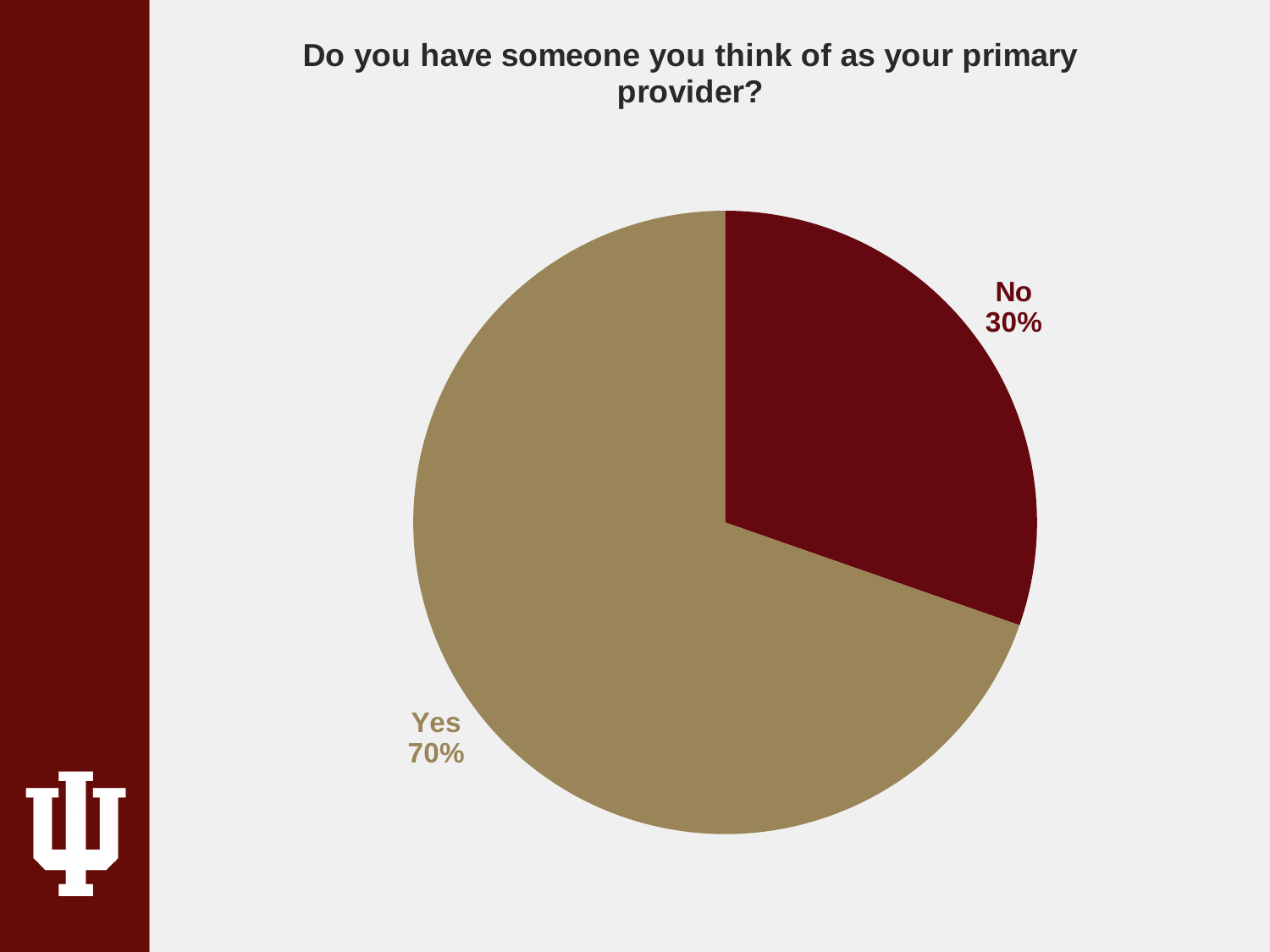
Which response has the largest share of the pie? Yes What kind of chart is shown on the slide? pie chart What colour is the Yes slice? tan/gold How many slices does the pie chart have? 2 Which is larger, the Yes slice or the No slice? Yes What percentage of respondents answered No? 30% Which response has the smallest share of the pie? No What is the difference in percentage points between the Yes and No slices? 40 What percentage of respondents answered Yes? 70% What is the title of the chart? Do you have someone you think of as your primary provider? What share of the pie does the No slice represent? 30%